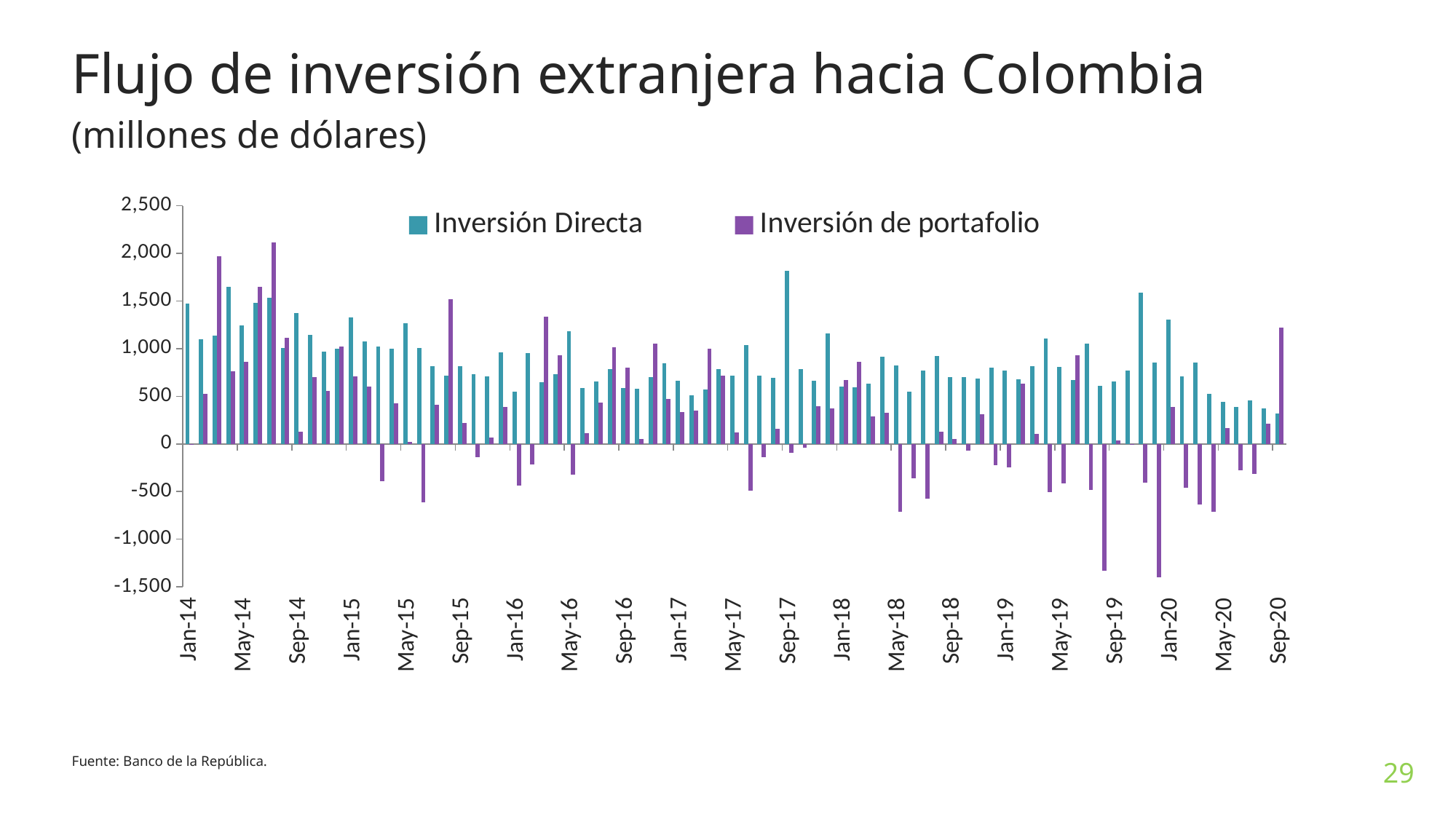
What kind of chart is shown on the slide? bar chart Is the Inversión Directa value for Jan-14 greater or less than 1,000? greater Is the Inversión Directa value for Sep-17 greater or less than 1,500? greater How many series does the legend list? 2 Is the Inversión de portafolio value for Jan-20 greater or less than -1,000? greater In Sep-20, which series has the larger value, Inversión Directa or Inversión de portafolio? Inversión de portafolio How many month labels are shown on the x axis? 21 In Jan-14, which series has the larger value, Inversión Directa or Inversión de portafolio? Inversión Directa What unit is given in the chart's subtitle? millones de dólares What are the two series named in the legend? Inversión Directa and Inversión de portafolio